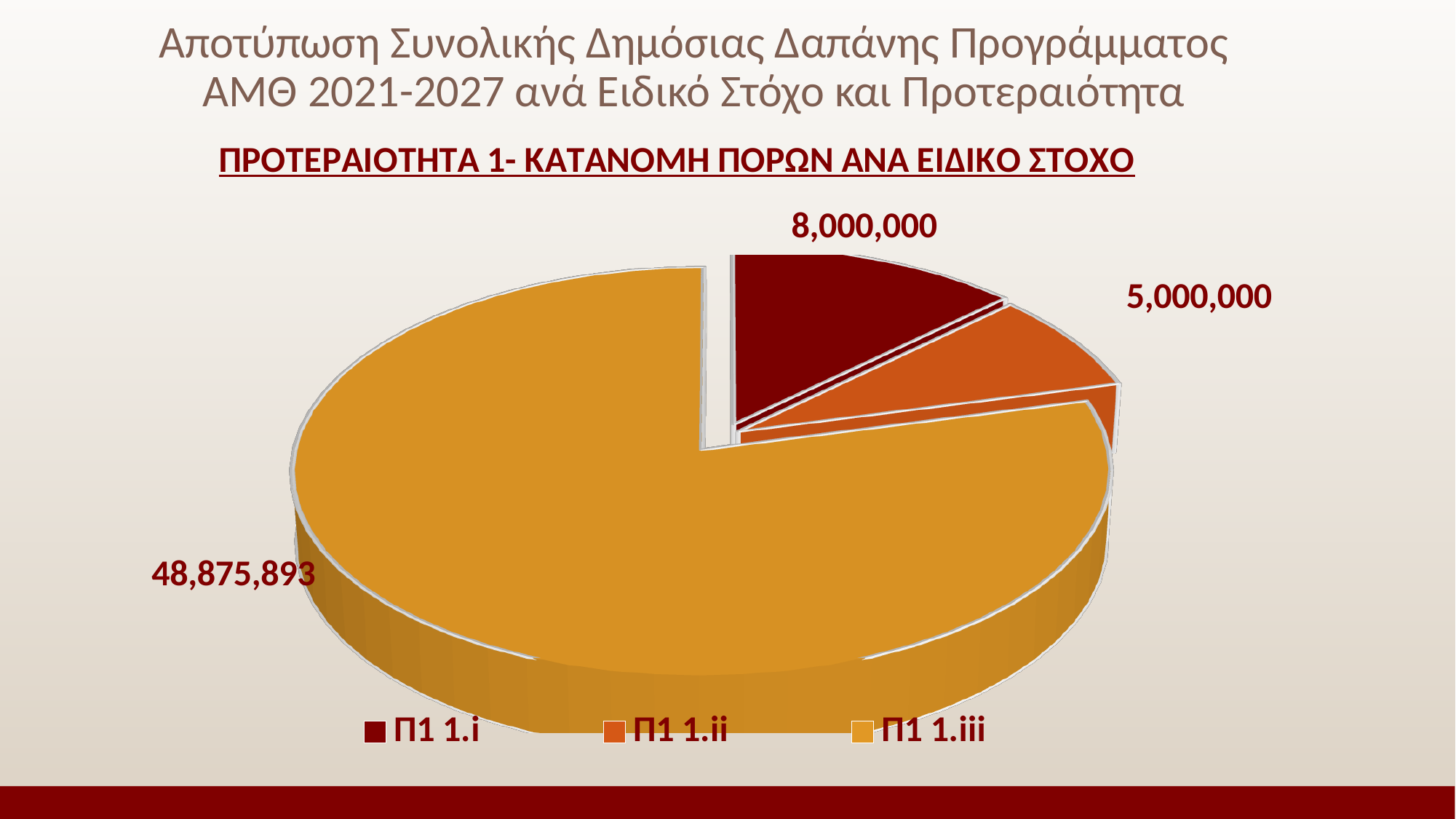
What is the value for Π1 1.ii? 5,000,000 How many categories does the pie chart show? 3 What is the difference between the values for Π1 1.iii and Π1 1.i? 40,875,893 Which is larger, the value for Π1 1.i or the value for Π1 1.ii? Π1 1.i What is the value for Π1 1.iii? 48,875,893 Which category has the largest slice of the pie? Π1 1.iii What is the difference between the values for Π1 1.i and Π1 1.ii? 3,000,000 What kind of chart is shown on the slide? Pie chart Which category has the smallest slice of the pie? Π1 1.ii What is the value for Π1 1.i? 8,000,000 What is the title of the pie chart? ΠΡΟΤΕΡΑΙΟΤΗΤΑ 1- ΚΑΤΑΝΟΜΗ ΠΟΡΩΝ ΑΝΑ ΕΙΔΙΚΟ ΣΤΟΧΟ What is the total of all three slices in the pie chart? 61,875,893